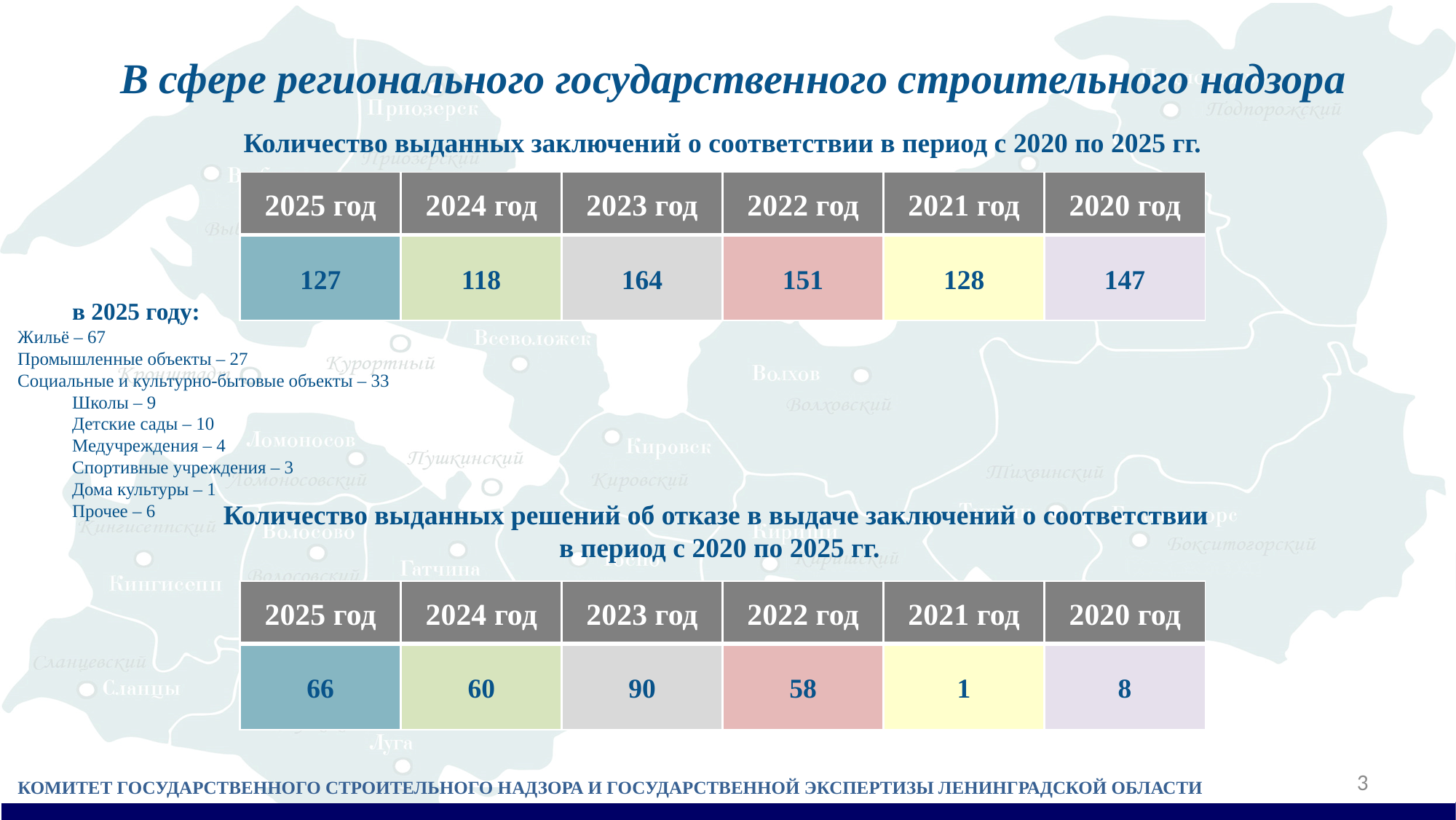
In the table 'Количество выданных заключений о соответствии в период с 2020 по 2025 гг.', which year has the lowest value? 2024 год In the table 'Количество выданных решений об отказе в выдаче заключений о соответствии в период с 2020 по 2025 гг.', what is the difference between the values for 2025 год and 2024 год? 6 In the table 'Количество выданных заключений о соответствии в период с 2020 по 2025 гг.', what is the value for 2025 год? 127 In the table 'Количество выданных заключений о соответствии в период с 2020 по 2025 гг.', what is the difference between the values for 2023 год and 2024 год? 46 In the table 'Количество выданных решений об отказе в выдаче заключений о соответствии в период с 2020 по 2025 гг.', which is larger, the value for 2022 год or 2020 год? 2022 год In the table 'Количество выданных заключений о соответствии в период с 2020 по 2025 гг.', what is the value for 2023 год? 164 In the table 'Количество выданных заключений о соответствии в период с 2020 по 2025 гг.', which year has the highest value? 2023 год In the table 'Количество выданных решений об отказе в выдаче заключений о соответствии в период с 2020 по 2025 гг.', which year has the highest value? 2023 год In the table 'Количество выданных решений об отказе в выдаче заключений о соответствии в период с 2020 по 2025 гг.', which year has the lowest value? 2021 год How many years are listed in the table 'Количество выданных заключений о соответствии в период с 2020 по 2025 гг.'? 6 In the table 'Количество выданных заключений о соответствии в период с 2020 по 2025 гг.', which is larger, the value for 2022 год or 2020 год? 2022 год In the table 'Количество выданных решений об отказе в выдаче заключений о соответствии в период с 2020 по 2025 гг.', what is the value for 2021 год? 1